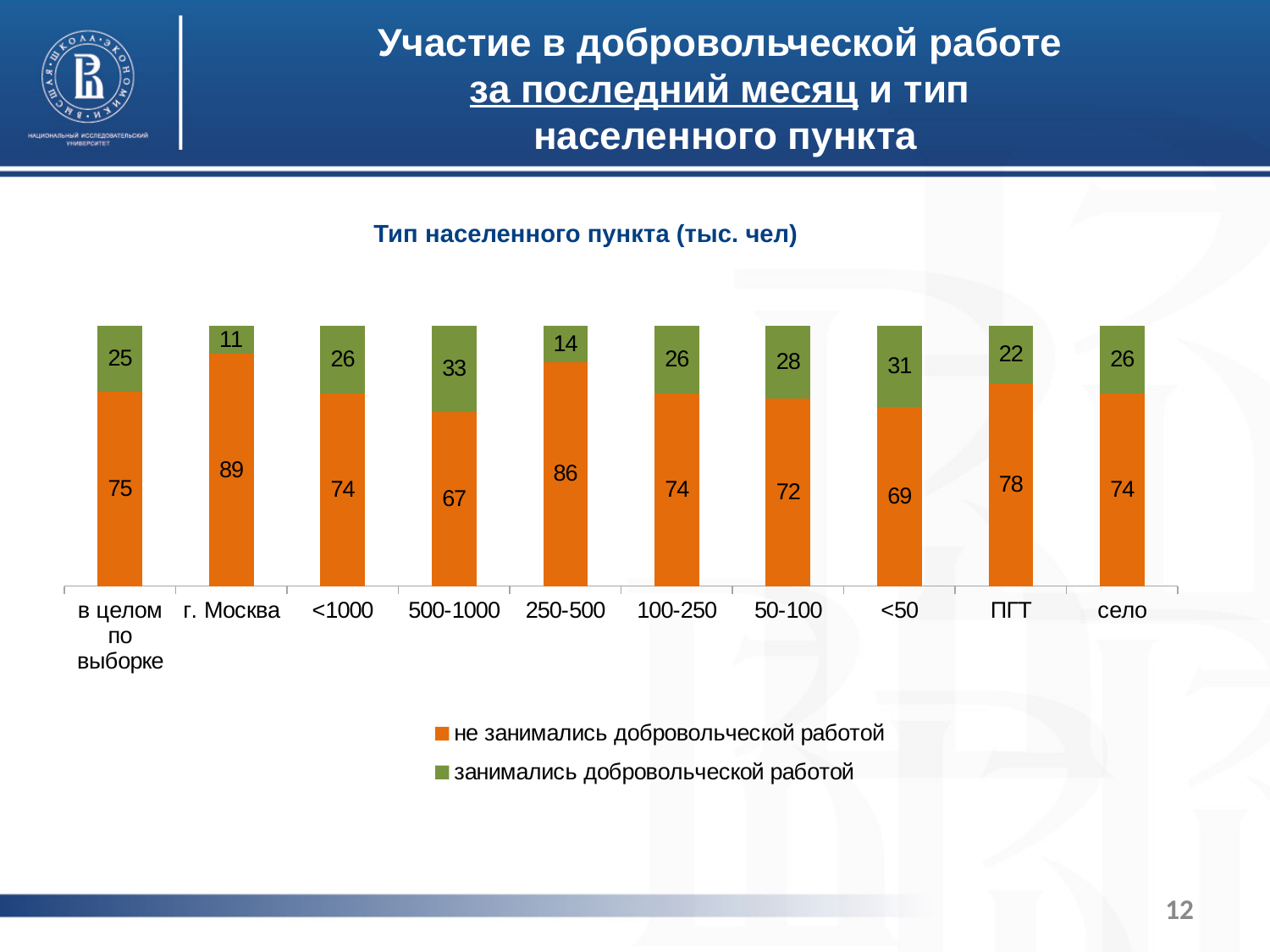
What value is shown for "занимались добровольческой работой" in the "г. Москва" category? 11 How many categories are shown on the x axis? 10 What is the difference between the "не занимались добровольческой работой" values for "г. Москва" and "село"? 15 What value is shown for "не занимались добровольческой работой" in the "500-1000" category? 67 How many series does the legend list? 2 Which category has the lowest value for "не занимались добровольческой работой"? 500-1000 What kind of chart is shown on the slide? stacked bar chart What value is shown for "занимались добровольческой работой" in the "<50" category? 31 Which category has the highest value for "занимались добровольческой работой"? 500-1000 Which is larger: the "занимались добровольческой работой" value for "ПГТ" or for "50-100"? 50-100 What is the title of the chart? Тип населенного пункта (тыс. чел) What is the total of the stacked bar for "250-500"? 100